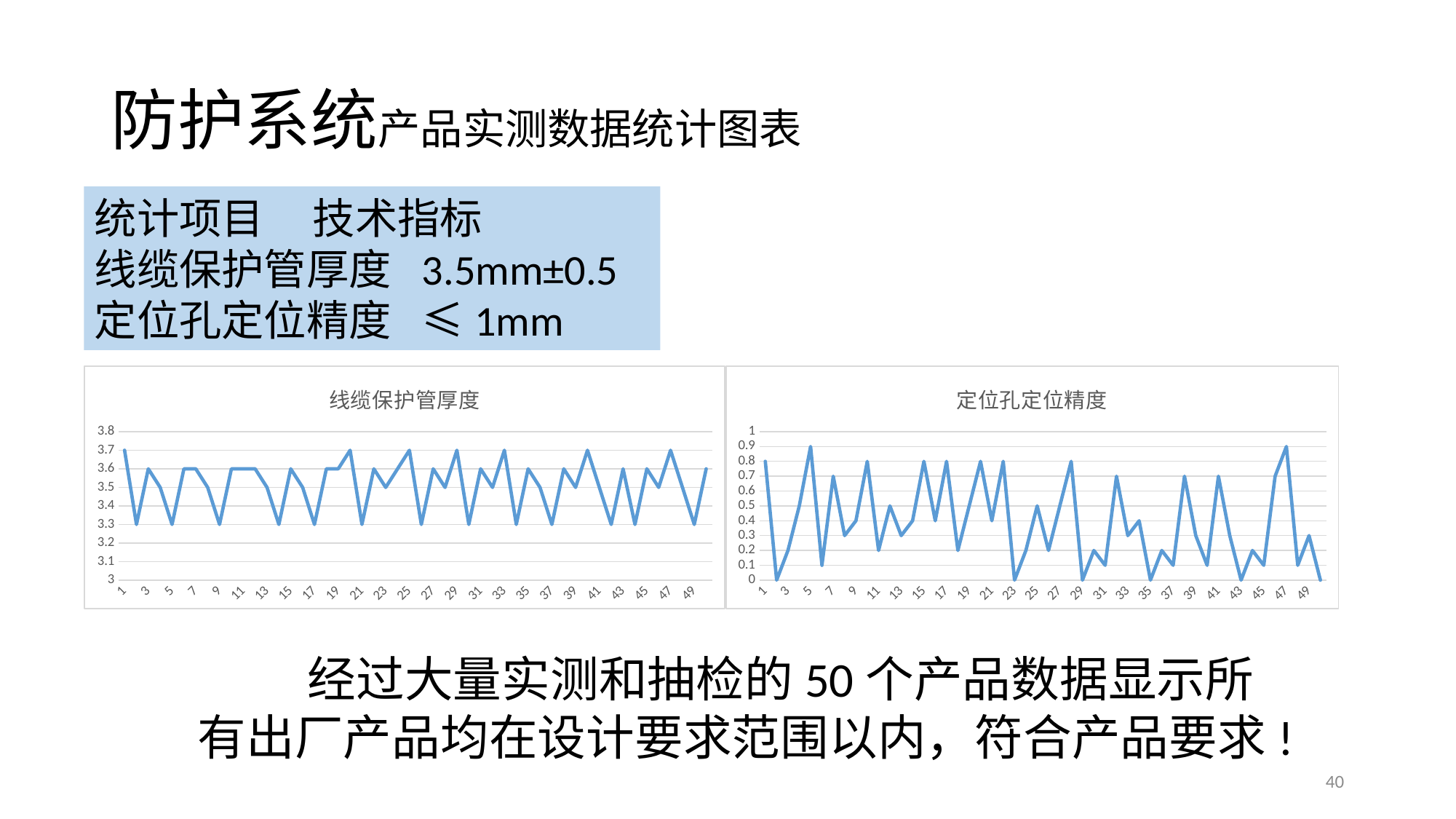
In the right chart 定位孔定位精度, is the value at point 1 larger or smaller than the value at point 2? larger In the left chart 线缆保护管厚度, what is the lowest value reached by the line? 3.3 What is the title of the left chart? 线缆保护管厚度 In the left chart 线缆保护管厚度, does the line rise steadily, fall steadily, or fluctuate along the x axis? fluctuate In the left chart 线缆保护管厚度, is the value at point 2 greater or less than 3.5? less In the right chart 定位孔定位精度, what is the value at point 1? 0.8 In the right chart 定位孔定位精度, is the value at point 5 greater or less than 0.5? greater In the left chart 线缆保护管厚度, what is the value at point 1? 3.7 In the right chart 定位孔定位精度, what is the highest value reached by the line? 0.9 What is the title of the right chart? 定位孔定位精度 What kind of chart is the left chart titled 线缆保护管厚度? line chart What kind of chart is the right chart titled 定位孔定位精度? line chart